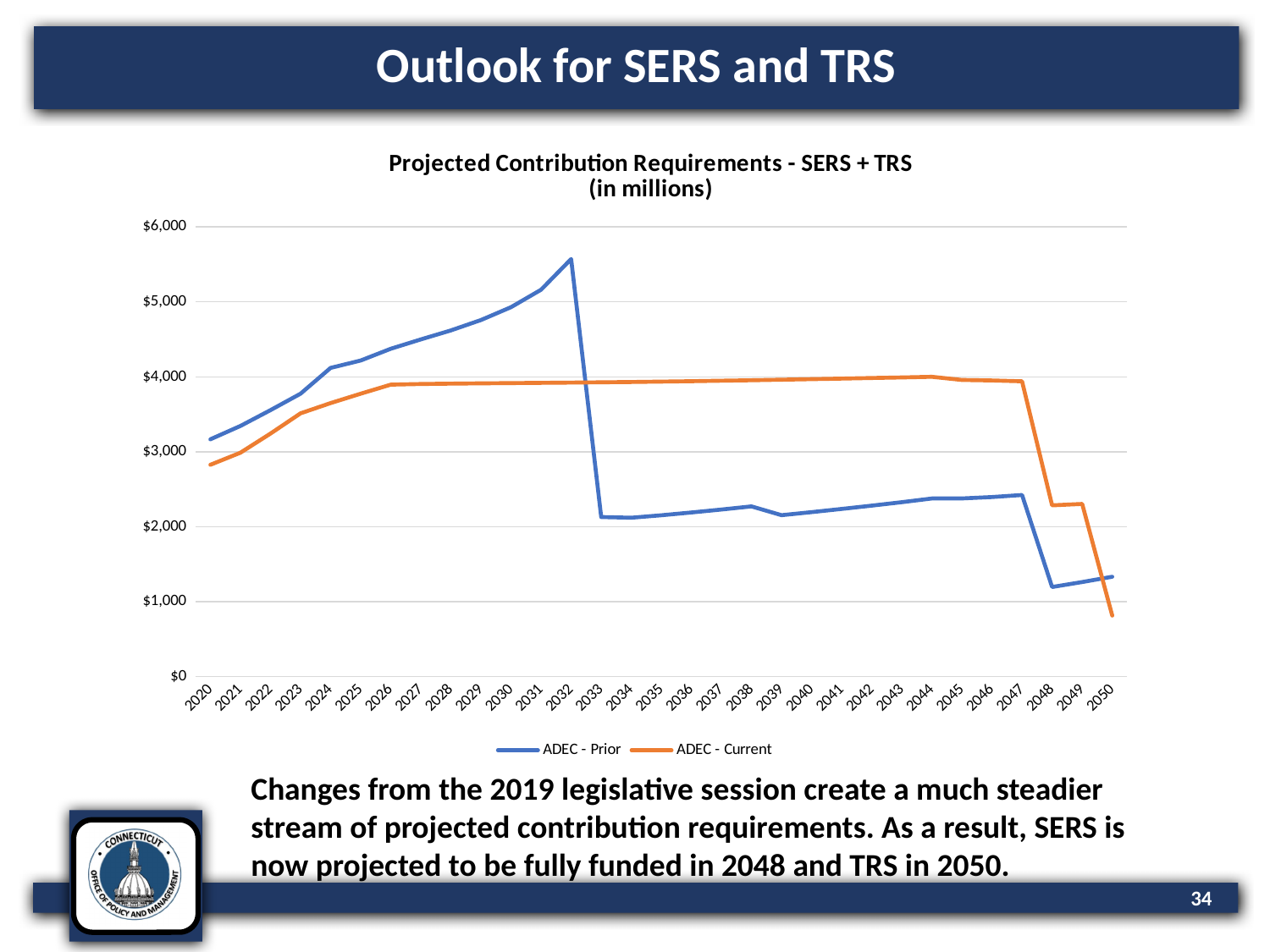
In which year does the ADEC - Prior series reach its highest value? 2032 What is the title of the chart? Projected Contribution Requirements - SERS + TRS (in millions) Is the value for ADEC - Current in 2050 greater or less than $1,000? less How many years are shown on the x axis? 31 What are the two series named in the legend? ADEC - Prior and ADEC - Current In which year does the ADEC - Current series reach its lowest value? 2050 Does the ADEC - Prior series rise or fall from 2020 to 2032? rise In 2040, which series has the larger value, ADEC - Prior or ADEC - Current? ADEC - Current Is the value for ADEC - Current in 2020 greater or less than $3,000? less Is the value for ADEC - Prior in 2032 greater or less than $5,000? greater How many series does the legend list? 2 What kind of chart is shown on the slide? line chart